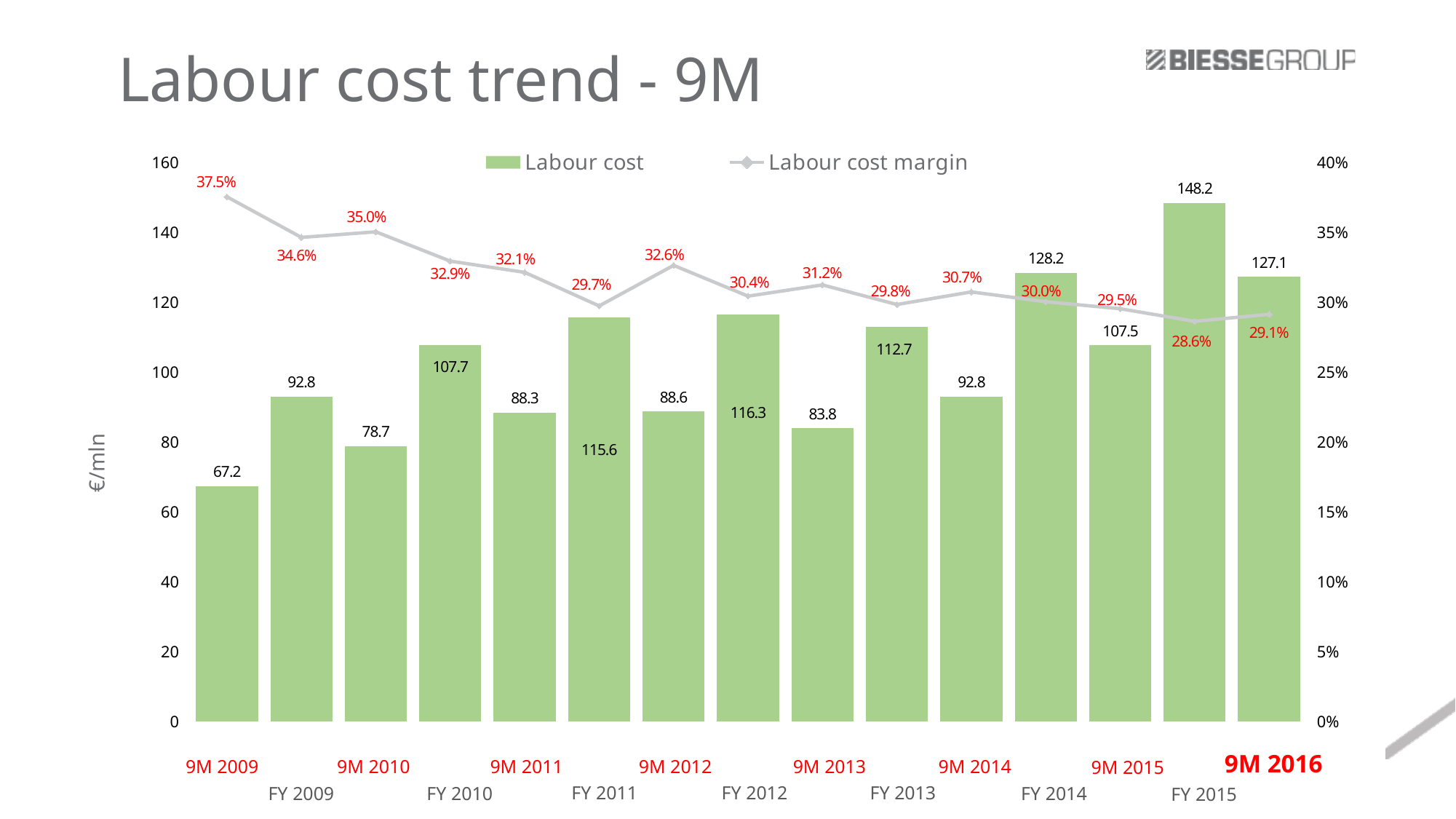
What is the labour cost margin for FY 2015? 28.6% How many series does the legend list? 2 What is the labour cost for 9M 2016? 127.1 What is the labour cost for FY 2013? 112.7 What is the difference in labour cost between 9M 2016 and 9M 2015? 19.6 Which period has the lowest labour cost margin? FY 2015 Which period has the lowest labour cost? 9M 2009 Which is larger, the labour cost for FY 2014 or for FY 2012? FY 2014 What is the labour cost margin for 9M 2009? 37.5% Which period has the highest labour cost? FY 2015 What is the overall trend of the labour cost margin from 9M 2009 to 9M 2016? falling How many periods are shown on the x axis? 15